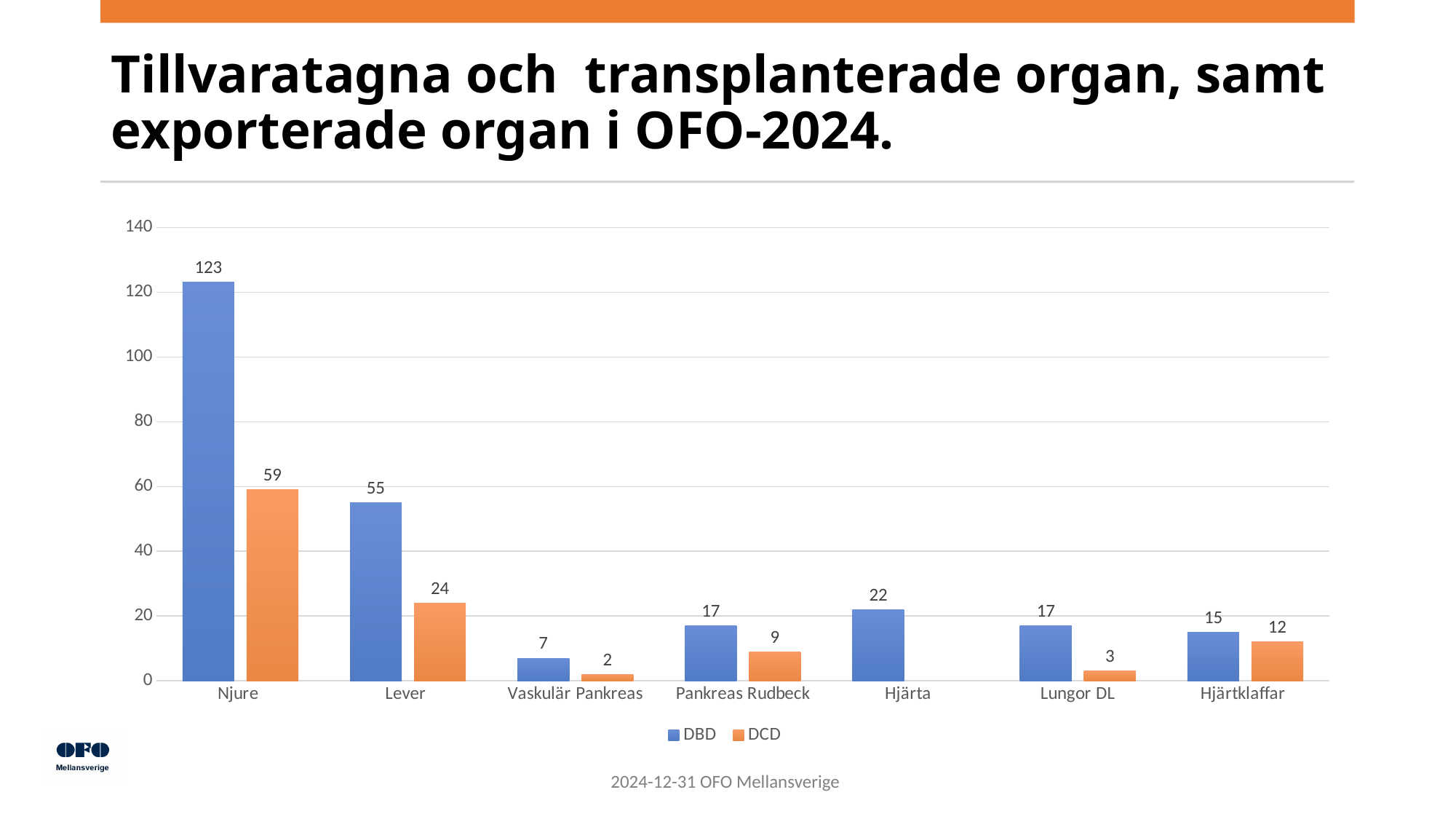
What is the DBD value for Hjärtklaffar? 15 What is the DCD value for Vaskulär Pankreas? 2 Which series is shown in orange? DCD What is the DCD value for Lever? 24 Which is larger, the DCD value for Pankreas Rudbeck or the DCD value for Lungor DL? Pankreas Rudbeck How many series does the legend list? 2 Which category has the highest DBD value? Njure How many categories are shown on the x axis? 7 What is the difference between the DBD and DCD values for Njure? 64 What is the DBD value for Njure? 123 Which category has the lowest DBD value? Vaskulär Pankreas What kind of chart is shown on the slide? Bar chart